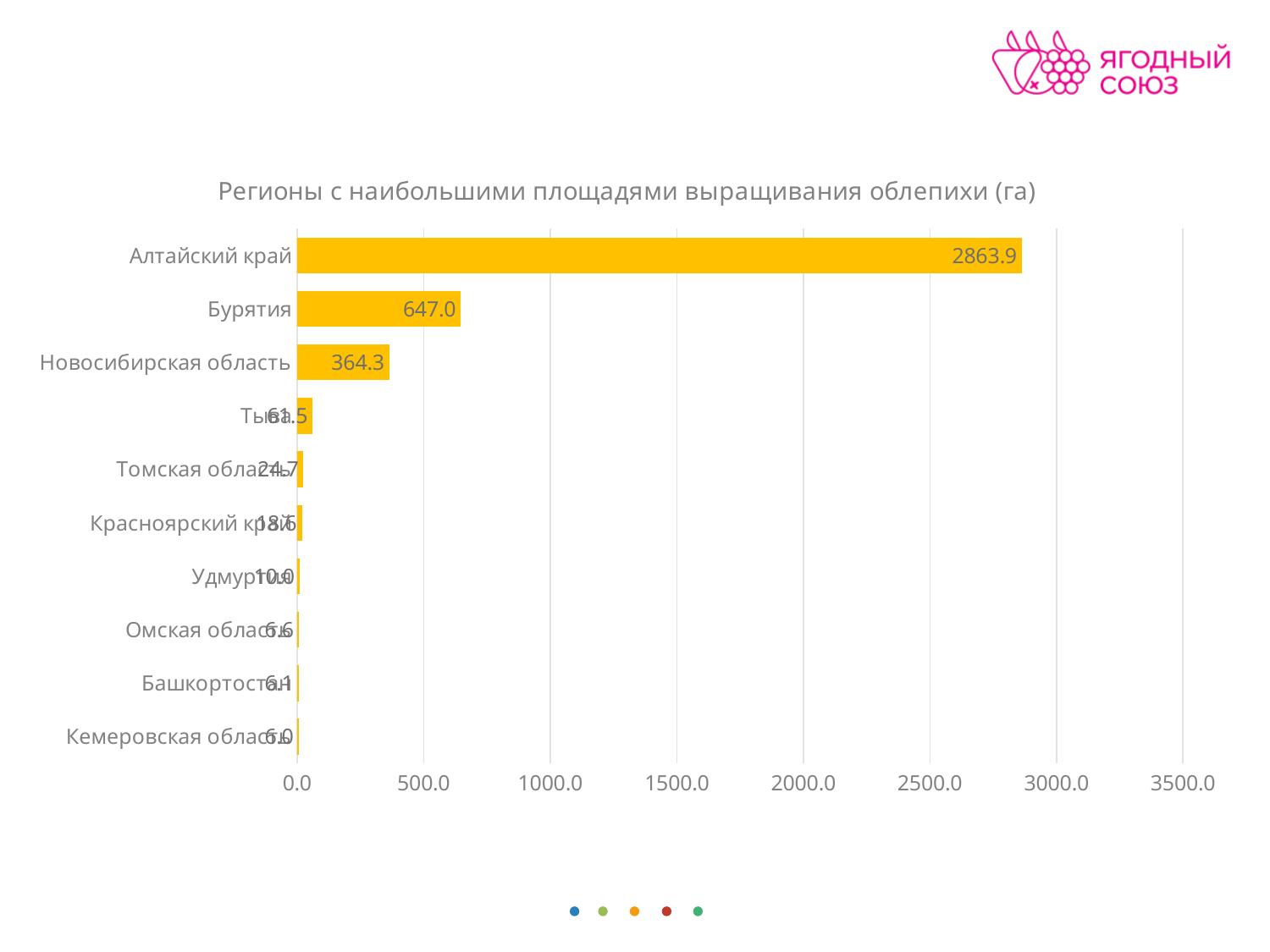
Which is larger, the value for Новосибирская область or the value for Тыва? Новосибирская область What is the value for Тыва? 61.5 How many regions are shown in the chart? 10 What is the value for Новосибирская область? 364.3 What is the title of the chart? Регионы с наибольшими площадями выращивания облепихи (га) Is the value for Бурятия greater or less than 500? greater Which region has the largest area? Алтайский край What is the value for Алтайский край? 2863.9 What is the value for Бурятия? 647.0 What is the difference between the values for Бурятия and Новосибирская область? 282.7 What kind of chart is shown on the slide? Bar chart What is the difference between the values for Алтайский край and Бурятия? 2216.9